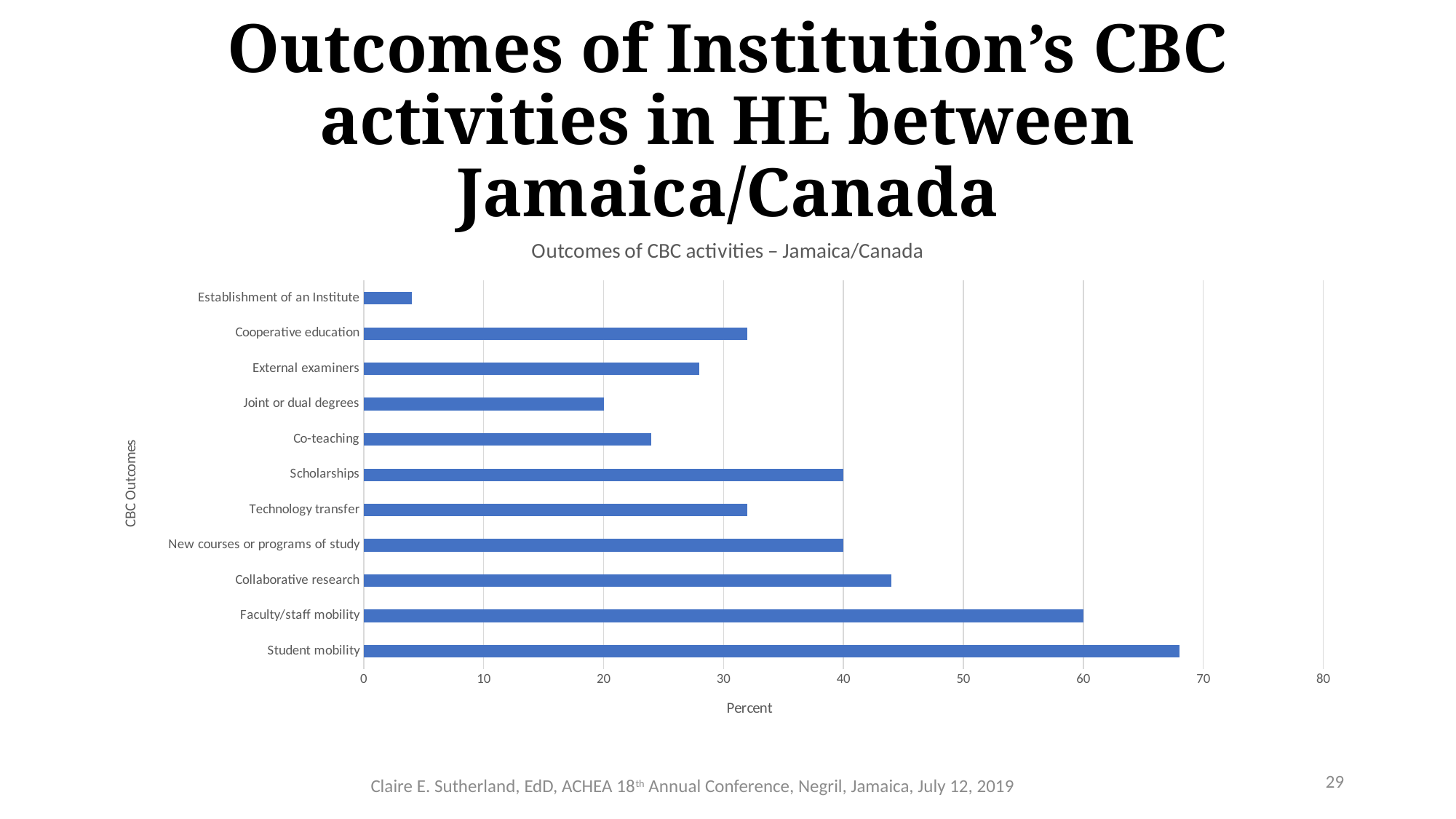
What is the percentage for Faculty/staff mobility? 60 Which CBC outcome has the highest percentage? Student mobility What is the label on the horizontal axis of the chart? Percent How many CBC outcome categories are plotted in the chart? 11 What is the percentage for Joint or dual degrees? 20 Which CBC outcome has the lowest percentage? Establishment of an Institute Is the value for Establishment of an Institute greater or less than 10? less Is the value for Collaborative research greater or less than 40? greater What is the title of the chart? Outcomes of CBC activities – Jamaica/Canada Is the value for Student mobility greater or less than 60? greater What kind of chart is shown on the slide? bar chart Which is larger, the value for Collaborative research or the value for Co-teaching? Collaborative research